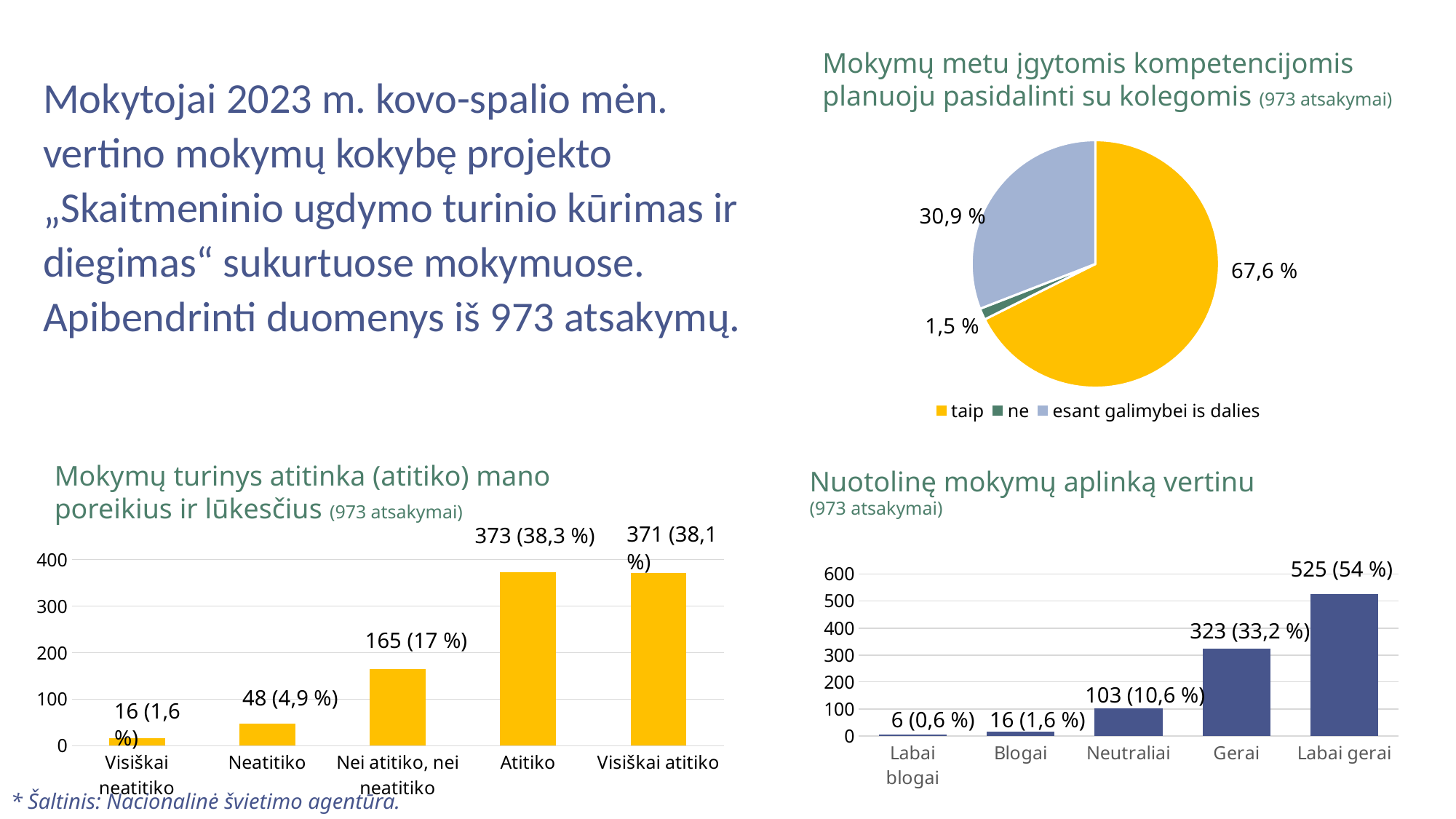
What type of chart is 'Nuotolinę mokymų aplinką vertinu'? bar chart How many categories are shown in the chart 'Mokymų turinys atitinka (atitiko) mano poreikius ir lūkesčius'? 5 In the chart 'Mokymų turinys atitinka (atitiko) mano poreikius ir lūkesčius', what is the difference in count between 'Atitiko' and 'Visiškai atitiko'? 2 How many entries does the legend of the pie chart 'Mokymų metu įgytomis kompetencijomis planuoju pasidalinti su kolegomis' list? 3 In the chart 'Nuotolinę mokymų aplinką vertinu', which category has the lowest value? Labai blogai In the pie chart 'Mokymų metu įgytomis kompetencijomis planuoju pasidalinti su kolegomis', which slice is the smallest? ne In the chart 'Nuotolinę mokymų aplinką vertinu', what is the value for 'Gerai'? 323 (33,2 %) In the chart 'Nuotolinę mokymų aplinką vertinu', do the values rise or fall from left to right along the x axis? rise In the chart 'Mokymų turinys atitinka (atitiko) mano poreikius ir lūkesčius', which category has the highest value? Atitiko In the chart 'Mokymų turinys atitinka (atitiko) mano poreikius ir lūkesčius', what is the value for 'Neatitiko'? 48 (4,9 %) In the chart 'Nuotolinę mokymų aplinką vertinu', which is larger: 'Neutraliai' or 'Blogai'? Neutraliai In the pie chart 'Mokymų metu įgytomis kompetencijomis planuoju pasidalinti su kolegomis', what share is labelled for 'taip'? 67,6 %